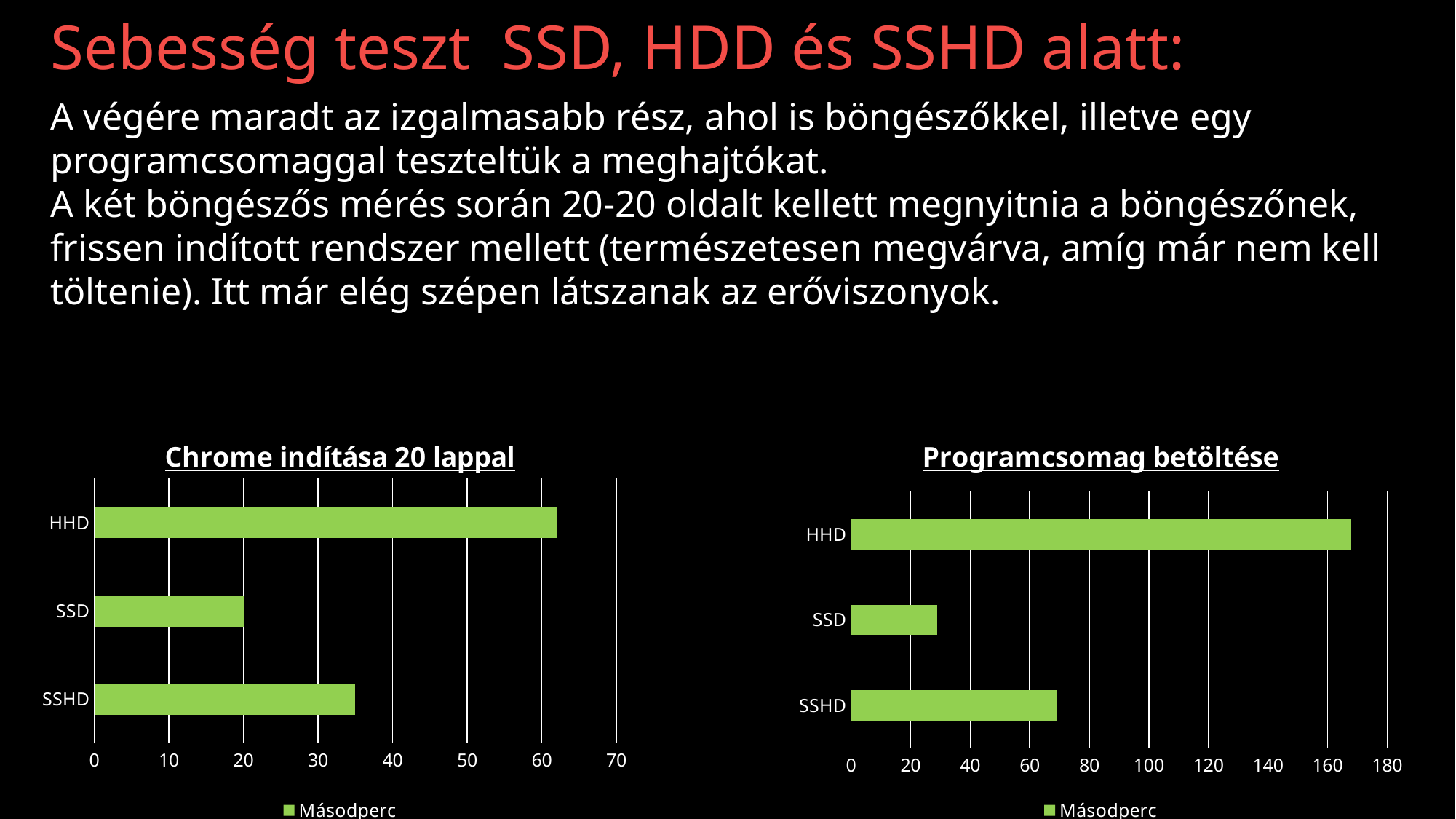
What type of chart is "Chrome indítása 20 lappal"? bar chart In the "Chrome indítása 20 lappal" chart, is the value for SSHD greater or less than 30? greater How many series does the legend of the "Programcsomag betöltése" chart list? 1 In the "Programcsomag betöltése" chart, which drive has the lowest value? SSD In the "Programcsomag betöltése" chart, is the value for SSD greater or less than 40? less In the "Programcsomag betöltése" chart, is the value for HHD greater or less than 160? greater In the "Chrome indítása 20 lappal" chart, which drive has the highest value? HHD In the "Programcsomag betöltése" chart, which is larger, the value for SSHD or the value for SSD? SSHD How many drive categories are shown in the "Chrome indítása 20 lappal" chart? 3 In the "Programcsomag betöltése" chart, which drive has the highest value? HHD In the "Chrome indítása 20 lappal" chart, which drive has the lowest value? SSD